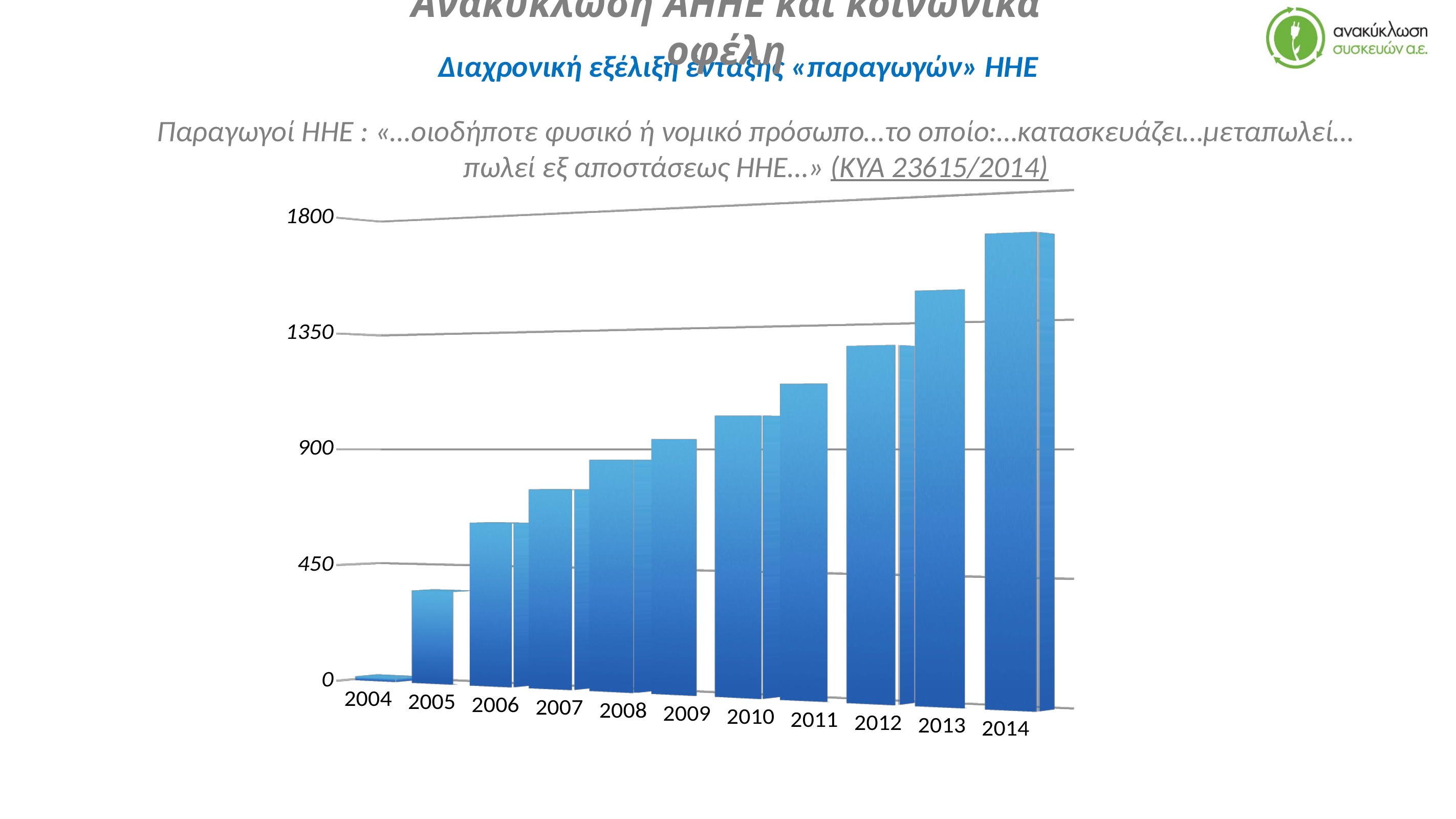
Which year has the lowest bar in the chart? 2004 Is the value for 2014 greater or less than 1800? less Is the value for 2010 greater or less than 900? greater Which year has the highest bar in the chart? 2014 Is the value for 2005 greater or less than 450? less How many years are shown on the x axis of the chart? 11 What kind of chart is shown on the slide? Bar chart What is the title of the chart on the slide? Διαχρονική εξέλιξη ένταξης «παραγωγών» ΗΗΕ Do the values in the chart rise or fall from 2004 to 2014? Rise Which year has the larger value, 2008 or 2012? 2012